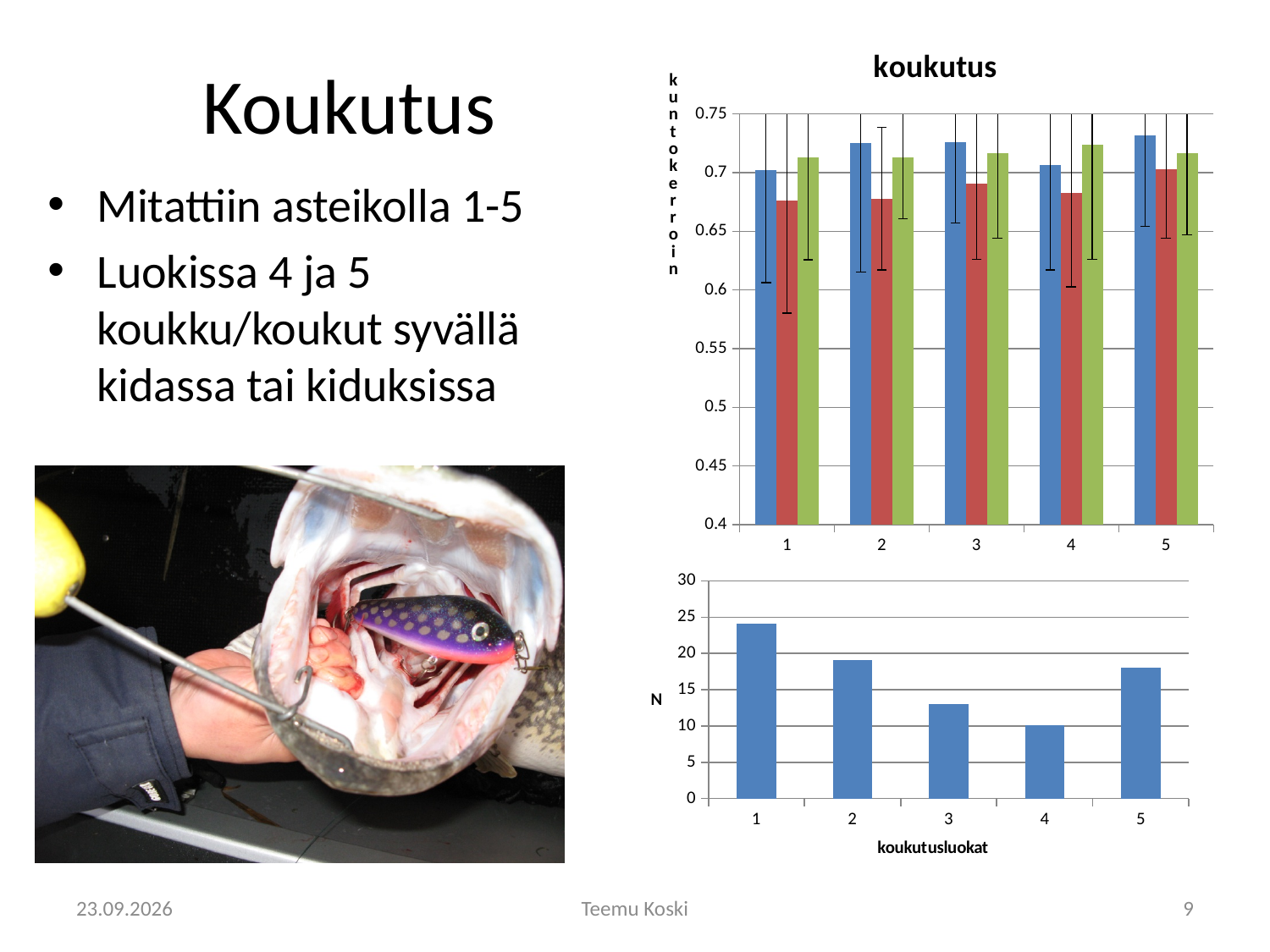
In the bottom chart (N by koukutusluokat), is the value for category 5 greater or less than 15? greater In the bottom chart (N by koukutusluokat), is the value for category 2 greater or less than 20? less What is the title of the top chart? koukutus In the bottom chart (N by koukutusluokat), which is larger, the value for category 2 or the value for category 3? category 2 In the bottom chart (N by koukutusluokat), what is the value for category 4? 10 In the bottom chart (N by koukutusluokat), which category has the lowest value? 4 In the bottom chart (N by koukutusluokat), which category has the highest value? 1 In the bottom chart (N by koukutusluokat), how many categories are shown on the x axis? 5 In the bottom chart (N by koukutusluokat), do the values rise or fall from category 1 to category 4? fall What kind of chart is the bottom chart with the y axis labelled N? bar chart In the bottom chart (N by koukutusluokat), is the value for category 1 greater or less than 20? greater